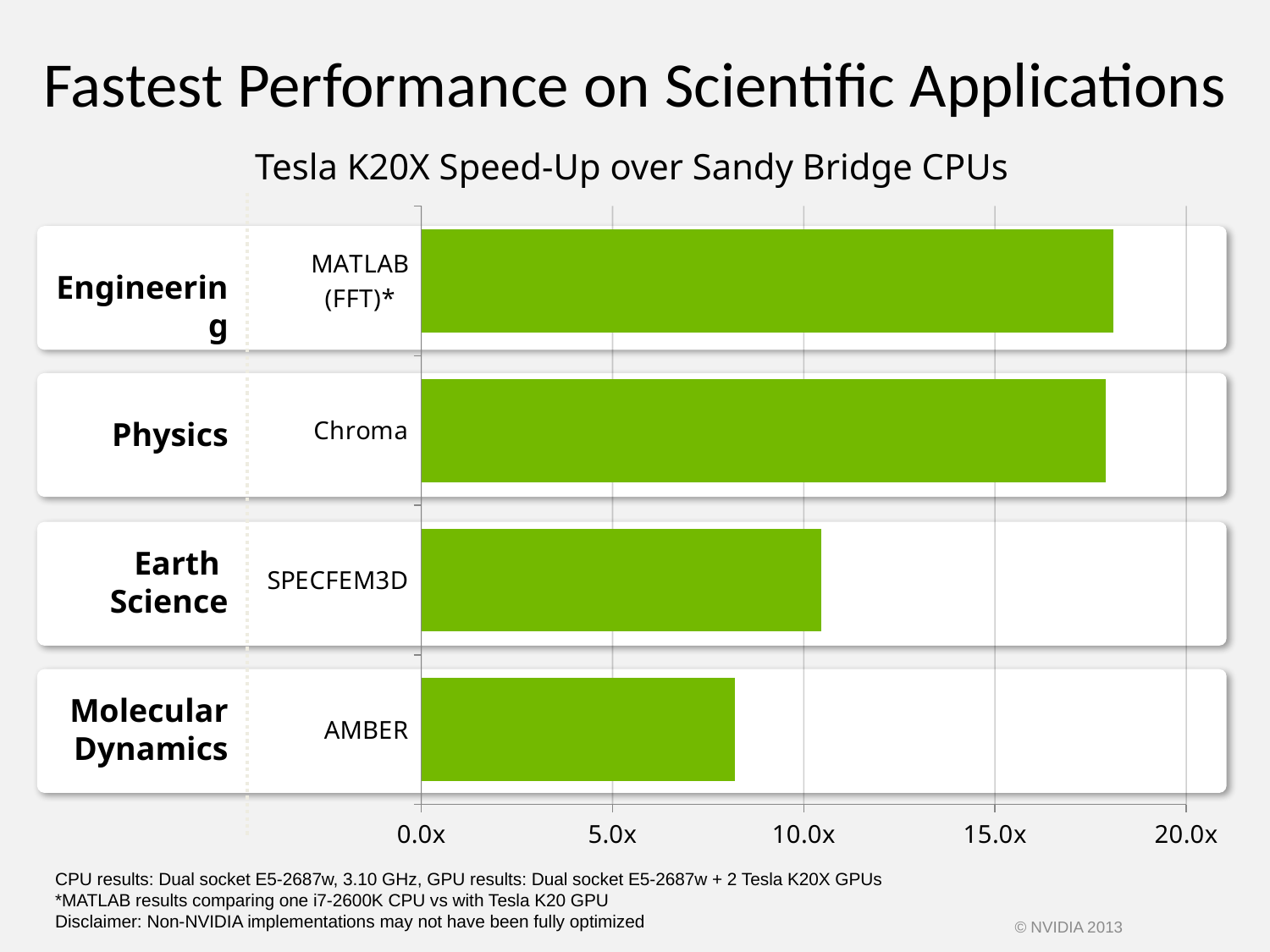
Which has the larger speed-up, SPECFEM3D or AMBER? SPECFEM3D Which has the larger speed-up, Chroma or SPECFEM3D? Chroma Which scientific domain is the Chroma application listed under? Physics Which application has the lowest speed-up? AMBER What kind of chart is shown on the slide? bar chart Is the speed-up for AMBER greater or less than 10.0x? less Is the speed-up for Chroma greater or less than 15.0x? greater Is the speed-up for MATLAB (FFT)* greater or less than 15.0x? greater What is the title of the chart? Tesla K20X Speed-Up over Sandy Bridge CPUs How many applications are plotted in the chart? 4